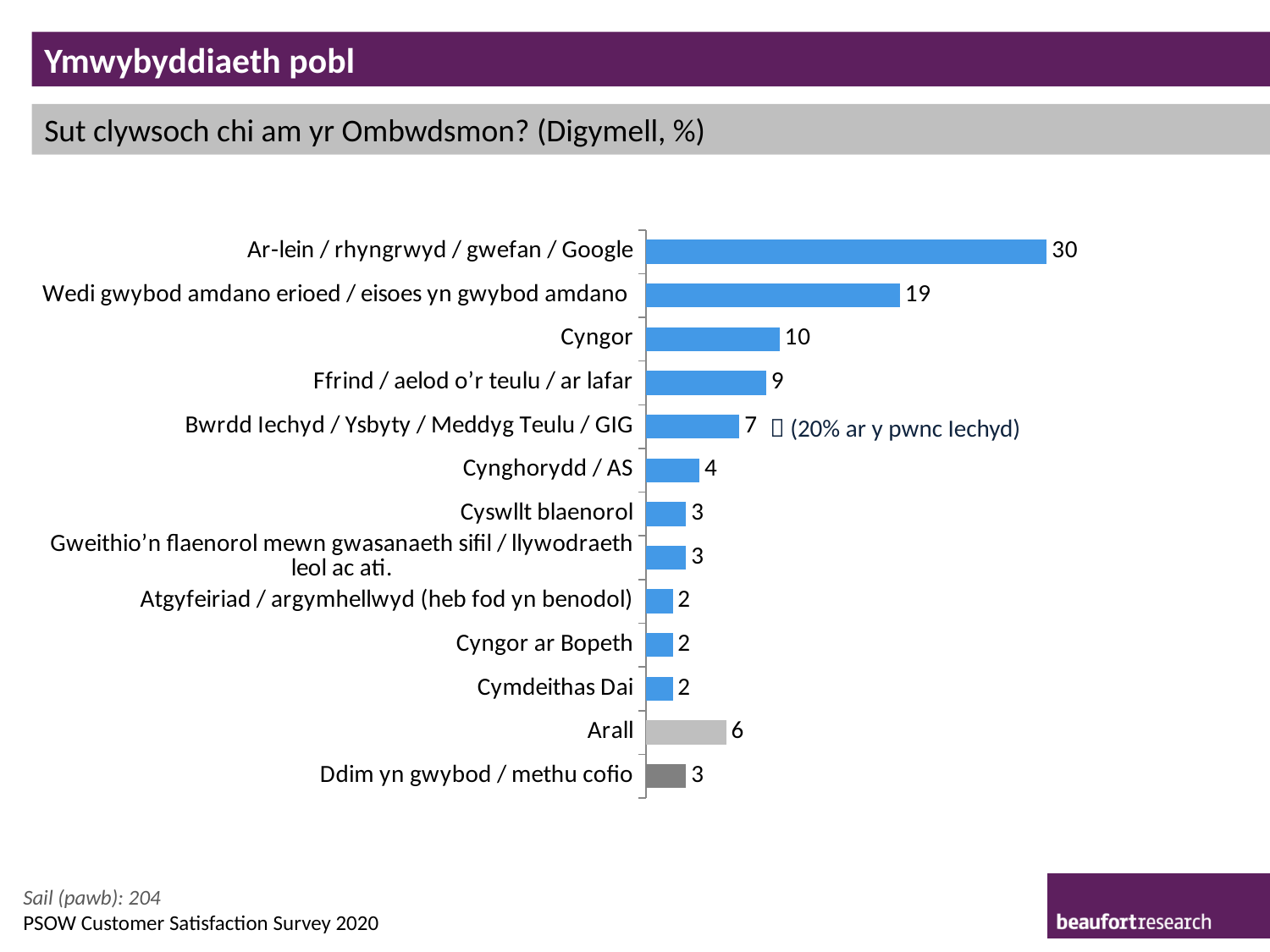
Which category has the highest value? Ar-lein / rhyngrwyd / gwefan / Google What is the difference between the values for Ar-lein / rhyngrwyd / gwefan / Google and Wedi gwybod amdano erioed / eisoes yn gwybod amdano? 11 What is the value for Ar-lein / rhyngrwyd / gwefan / Google? 30 What is the value for Ddim yn gwybod / methu cofio? 3 What is the value for Cyngor? 10 What is the base (Sail) shown on the slide? 204 What kind of chart is shown on the slide? Bar chart What is the value for Arall? 6 How many categories are shown in the chart? 13 Which is larger, the value for Ffrind / aelod o'r teulu / ar lafar or the value for Arall? Ffrind / aelod o'r teulu / ar lafar What is the value for Bwrdd Iechyd / Ysbyty / Meddyg Teulu / GIG? 7 What is the difference between the values for Cyngor and Cynghorydd / AS? 6